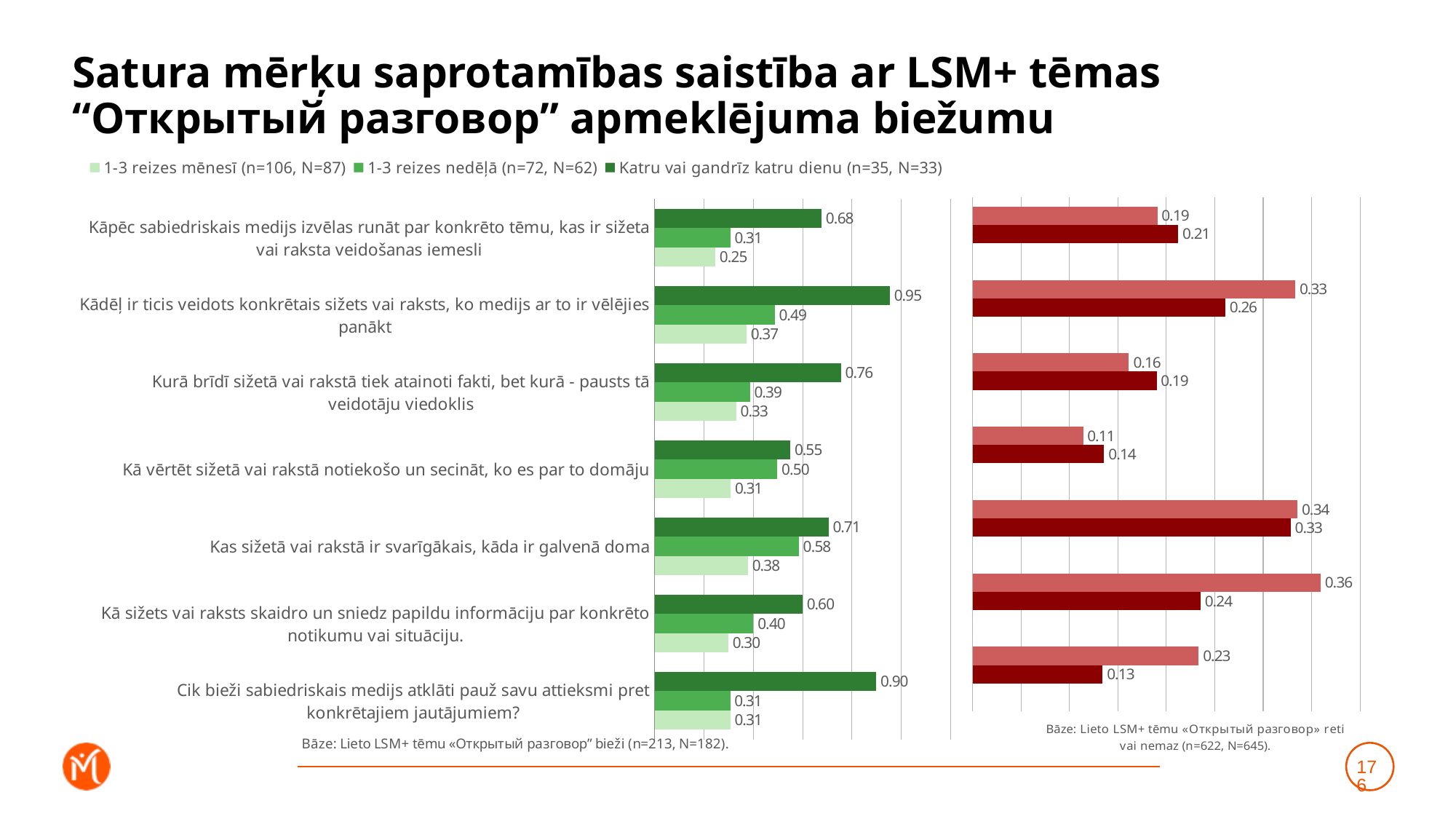
According to the base note under the left (green) chart, what are the n and N values? n=213, N=182 In the left (green) chart, which category has the lowest value for '1-3 reizes mēnesī'? Kāpēc sabiedriskais medijs izvēlas runāt par konkrēto tēmu, kas ir sižeta vai raksta veidošanas iemesli How many categories are shown in the left (green) chart? 7 What kind of chart is the left (green) chart? Bar chart In the left (green) chart, which category has the larger '1-3 reizes nedēļā' value: 'Kā vērtēt sižetā vai rakstā notiekošo un secināt, ko es par to domāju' or 'Kas sižetā vai rakstā ir svarīgākais, kāda ir galvenā doma'? Kas sižetā vai rakstā ir svarīgākais, kāda ir galvenā doma In the left (green) chart, which category has the highest value for 'Katru vai gandrīz katru dienu'? Kādēļ ir ticis veidots konkrētais sižets vai raksts, ko medijs ar to ir vēlējies panākt In the right (red) chart, what is the highest value shown on any bar? 0.36 In the left (green) chart, what is the value for 'Katru vai gandrīz katru dienu' for the category 'Kādēļ ir ticis veidots konkrētais sižets vai raksts, ko medijs ar to ir vēlējies panākt'? 0.95 In the left (green) chart, what is the value for '1-3 reizes mēnesī' for the category 'Kas sižetā vai rakstā ir svarīgākais, kāda ir galvenā doma'? 0.38 In the left (green) chart, what is the difference between the 'Katru vai gandrīz katru dienu' value and the '1-3 reizes nedēļā' value for 'Cik bieži sabiedriskais medijs atklāti pauž savu attieksmi pret konkrētajiem jautājumiem?'? 0.59 How many series does the legend of the left (green) chart list? 3 In the right (red) chart, what is the value of the upper (lighter red) bar for 'Kā sižets vai raksts skaidro un sniedz papildu informāciju par konkrēto notikumu vai situāciju.'? 0.36